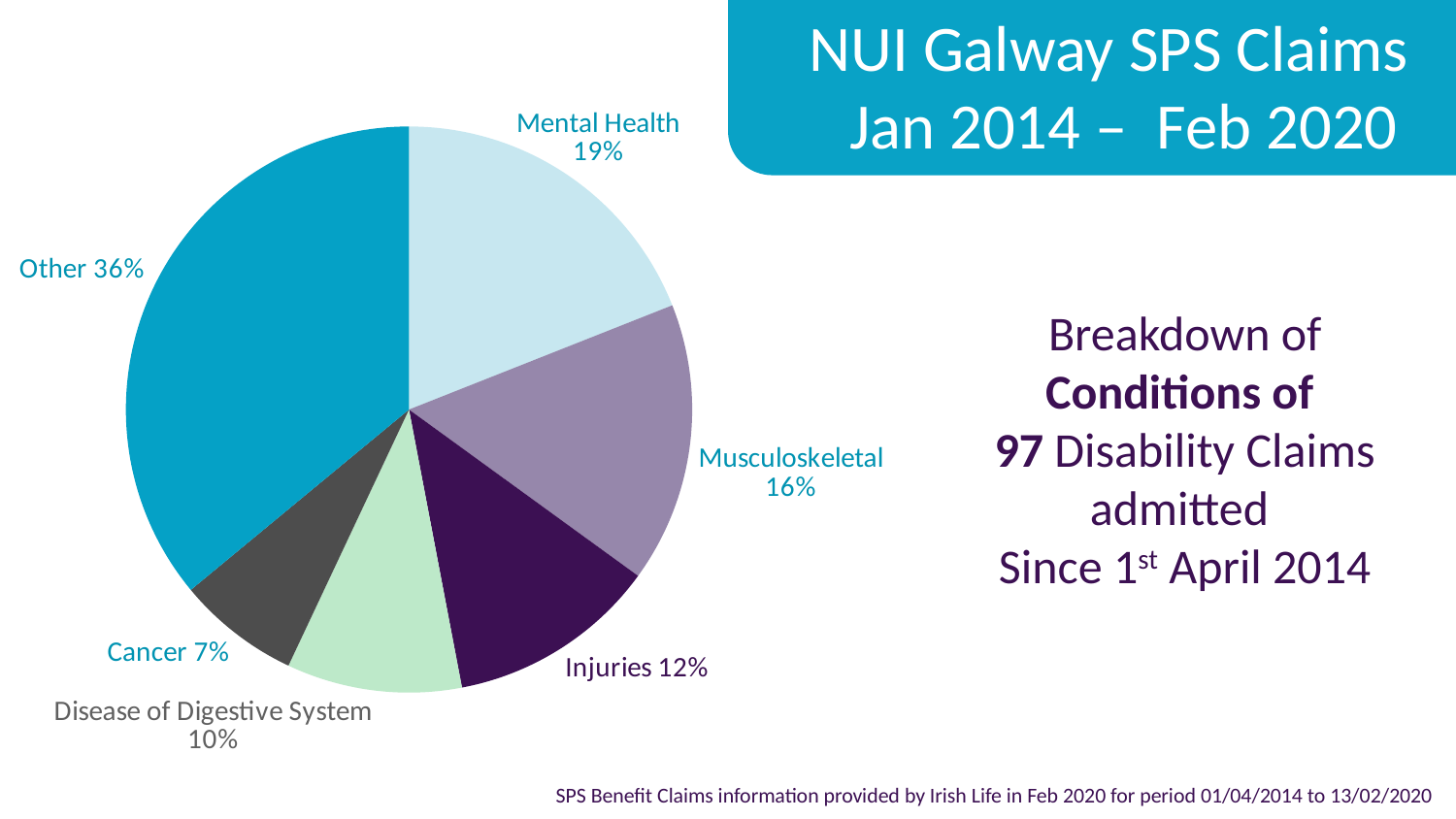
Which is larger, the Musculoskeletal slice or the Injuries slice? Musculoskeletal What share of claims is attributed to Musculoskeletal conditions? 16% What percentage of claims is labelled Injuries? 12% How many categories are shown in the pie chart? 6 What kind of chart is shown on the slide? pie chart What is the difference in percentage points between Other and Mental Health? 17 Which category has the largest slice of the pie? Other What share of claims is attributed to Mental Health? 19% Which category has the smallest slice of the pie? Cancer What percentage of claims is labelled Disease of Digestive System? 10% What percentage of claims is labelled Cancer? 7% How many disability claims does the slide say the breakdown covers? 97